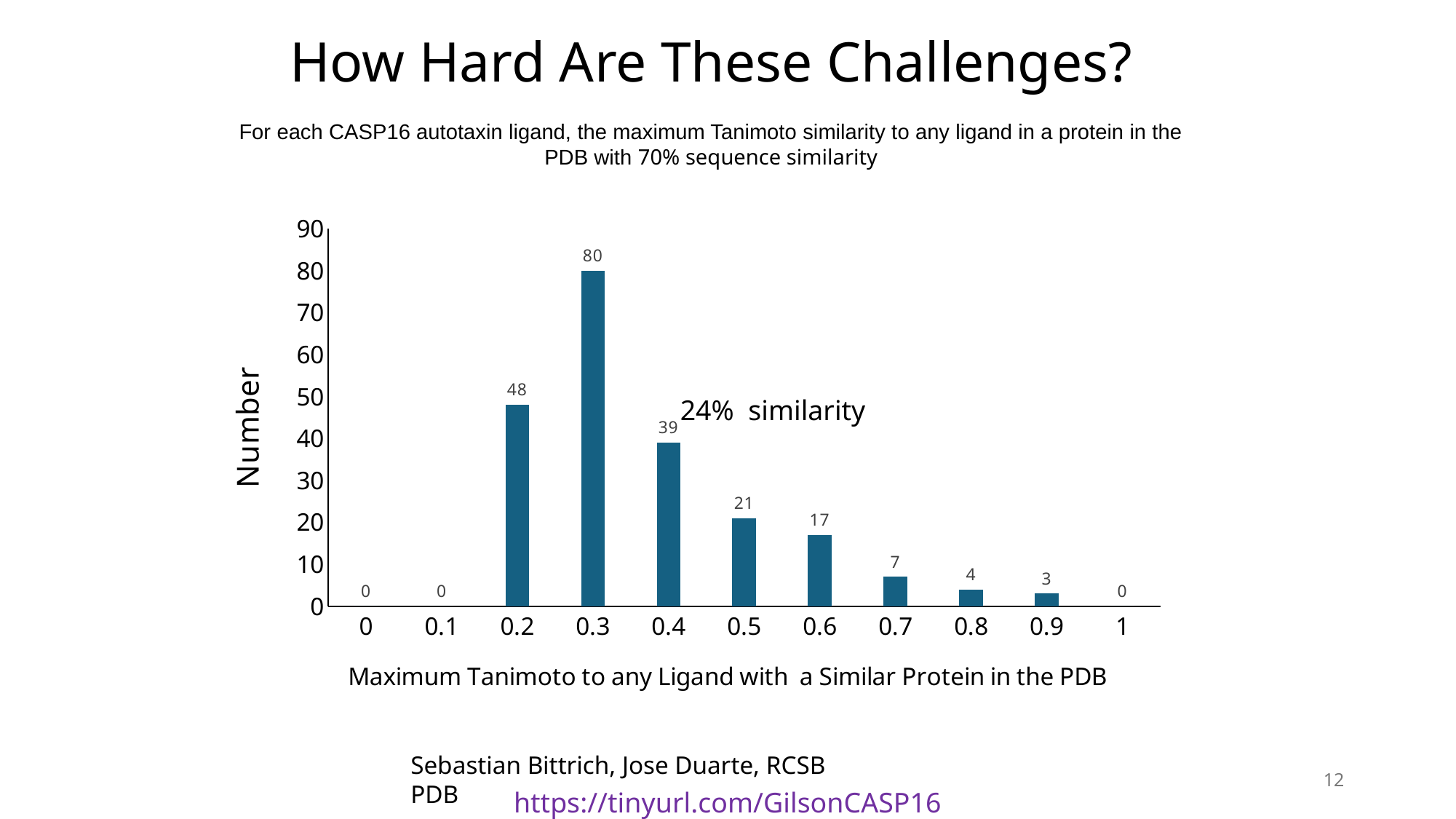
What is the difference between the values for the 0.4 and 0.5 bins? 18 Which x-axis bin has the highest value? 0.3 How many x-axis bins are shown on the chart? 11 What is the value for the 0.9 bin? 3 Do the values rise or fall along the x axis from 0.3 to 1? fall What is the value for the 0.3 bin? 80 Which is larger, the value for 0.2 or the value for 0.4? 0.2 What is the difference between the values for the 0.3 and 0.2 bins? 32 What kind of chart is shown? bar chart How many bins have a value of 0? 3 What is the y-axis label of the chart? Number What is the value for the 0.6 bin? 17